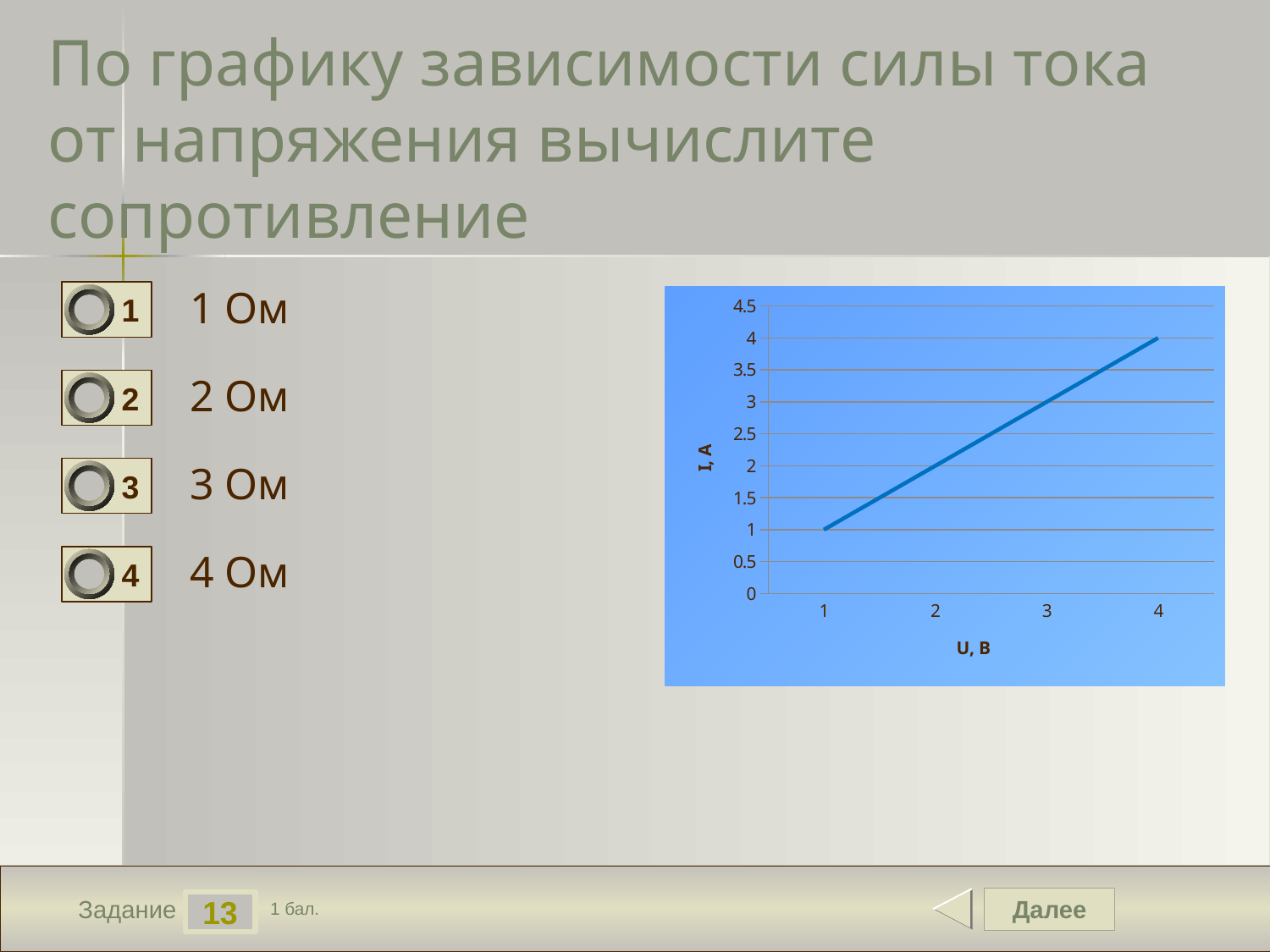
What is the difference between the value of I at U = 4 and the value of I at U = 1? 3 What is the value of I, A when U, B is 1? 1 What is the value of I, A when U, B is 2? 2 What kind of chart is shown on the slide? line chart What is the value of I, A when U, B is 4? 4 At which value of U, B is the current I lowest? 1 What is the label of the vertical axis of the chart? I, A How many values of U, B are marked on the horizontal axis? 4 What is the label of the horizontal axis of the chart? U, B Does the current I rise or fall as the voltage U increases along the x axis? rises At which value of U, B is the current I highest? 4 Is the value of I at U = 3 greater or less than 2.5? greater